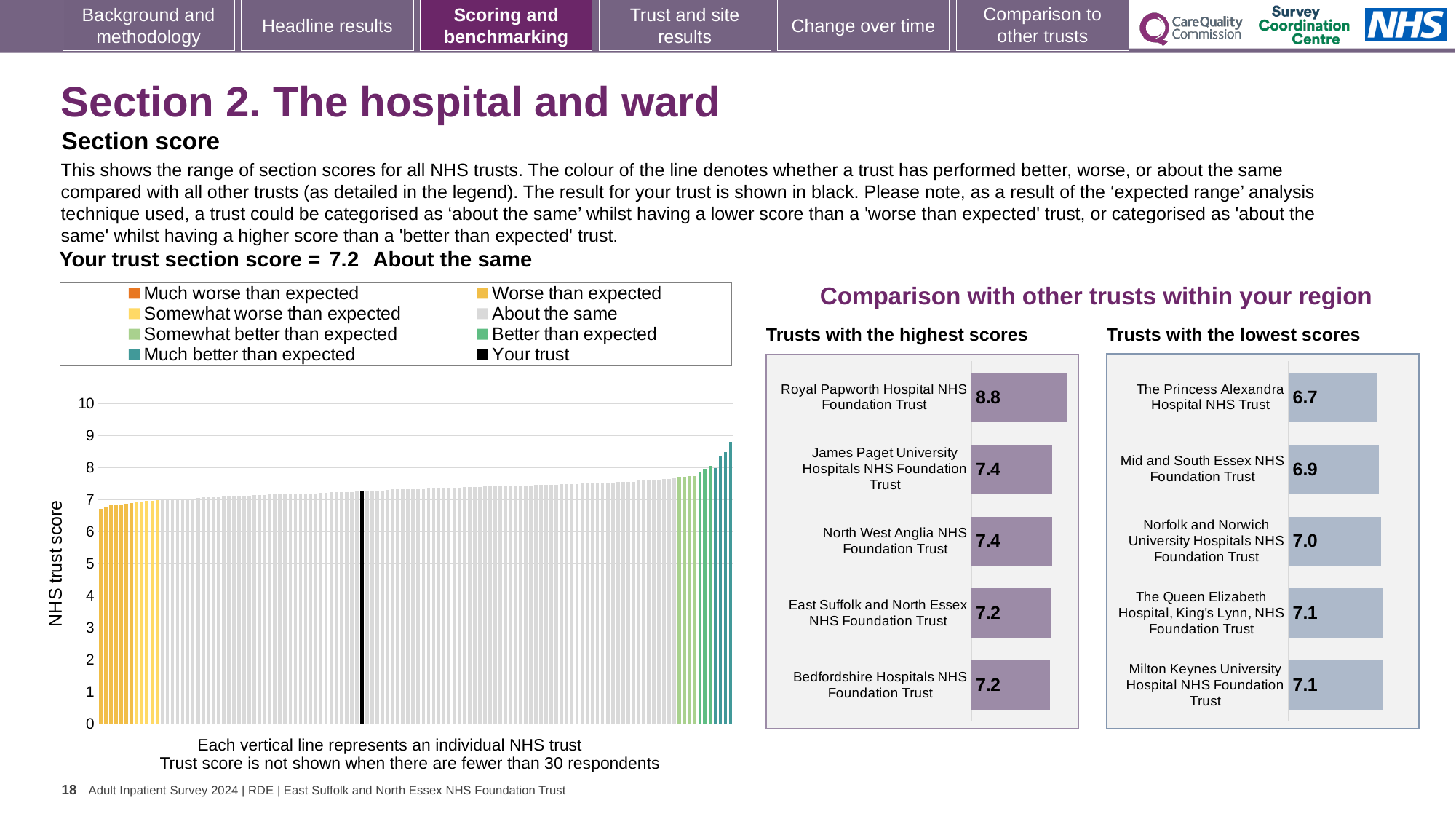
In the 'Trusts with the highest scores' chart, what is the difference between the scores of Royal Papworth Hospital NHS Foundation Trust and Bedfordshire Hospitals NHS Foundation Trust? 1.6 In the 'Trusts with the lowest scores' chart, what is the score for The Princess Alexandra Hospital NHS Trust? 6.7 In the large chart on the left showing all NHS trusts, is the value of the tallest bar greater or less than 8? greater In the 'Trusts with the lowest scores' chart, which trust has the lowest score? The Princess Alexandra Hospital NHS Trust In the large chart on the left showing all NHS trusts, do the bar values rise or fall from left to right? rise In the 'Trusts with the highest scores' chart, what is the score for Royal Papworth Hospital NHS Foundation Trust? 8.8 In the 'Trusts with the lowest scores' chart, what is the score for Milton Keynes University Hospital NHS Foundation Trust? 7.1 How many trusts are shown in the 'Trusts with the lowest scores' chart? 5 In the large chart on the left showing all NHS trusts, what is the section score for your trust (the black bar)? 7.2 In the 'Trusts with the lowest scores' chart, which has the larger score: Mid and South Essex NHS Foundation Trust or Norfolk and Norwich University Hospitals NHS Foundation Trust? Norfolk and Norwich University Hospitals NHS Foundation Trust How many entries does the legend of the large chart on the left list? 8 In the 'Trusts with the highest scores' chart, which trust has the highest score? Royal Papworth Hospital NHS Foundation Trust